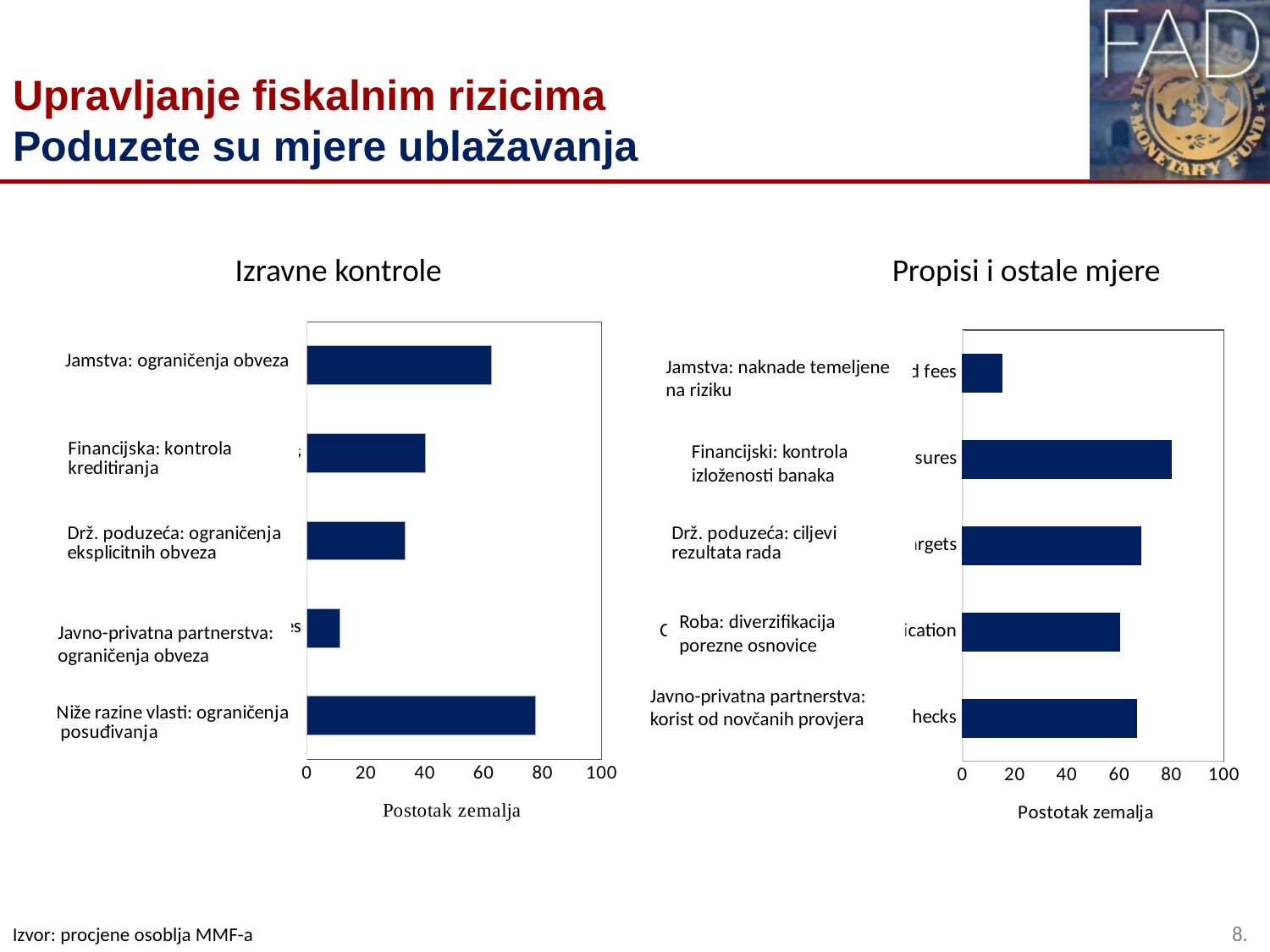
How many categories does the "Izravne kontrole" chart show? 5 In the "Propisi i ostale mjere" chart, is the value for "Roba: diverzifikacija porezne osnovice" greater or less than 40? greater What is the x-axis title of the "Propisi i ostale mjere" chart? Postotak zemalja How many categories does the "Propisi i ostale mjere" chart show? 5 In the "Izravne kontrole" chart, which is larger: "Financijska: kontrola kreditiranja" or "Drž. poduzeća: ograničenja eksplicitnih obveza"? Financijska: kontrola kreditiranja What kind of chart is the "Izravne kontrole" chart? bar chart In the "Izravne kontrole" chart, which category has the highest value? Niže razine vlasti: ograničenja posuđivanja In the "Propisi i ostale mjere" chart, which category has the lowest value? Jamstva: naknade temeljene na riziku In the "Izravne kontrole" chart, which category has the lowest value? Javno-privatna partnerstva: ograničenja obveza In the "Propisi i ostale mjere" chart, which category has the highest value? Financijski: kontrola izloženosti banaka In the "Izravne kontrole" chart, is the value for "Javno-privatna partnerstva: ograničenja obveza" greater or less than 20? less In the "Izravne kontrole" chart, is the value for "Jamstva: ograničenja obveza" greater or less than 60? greater